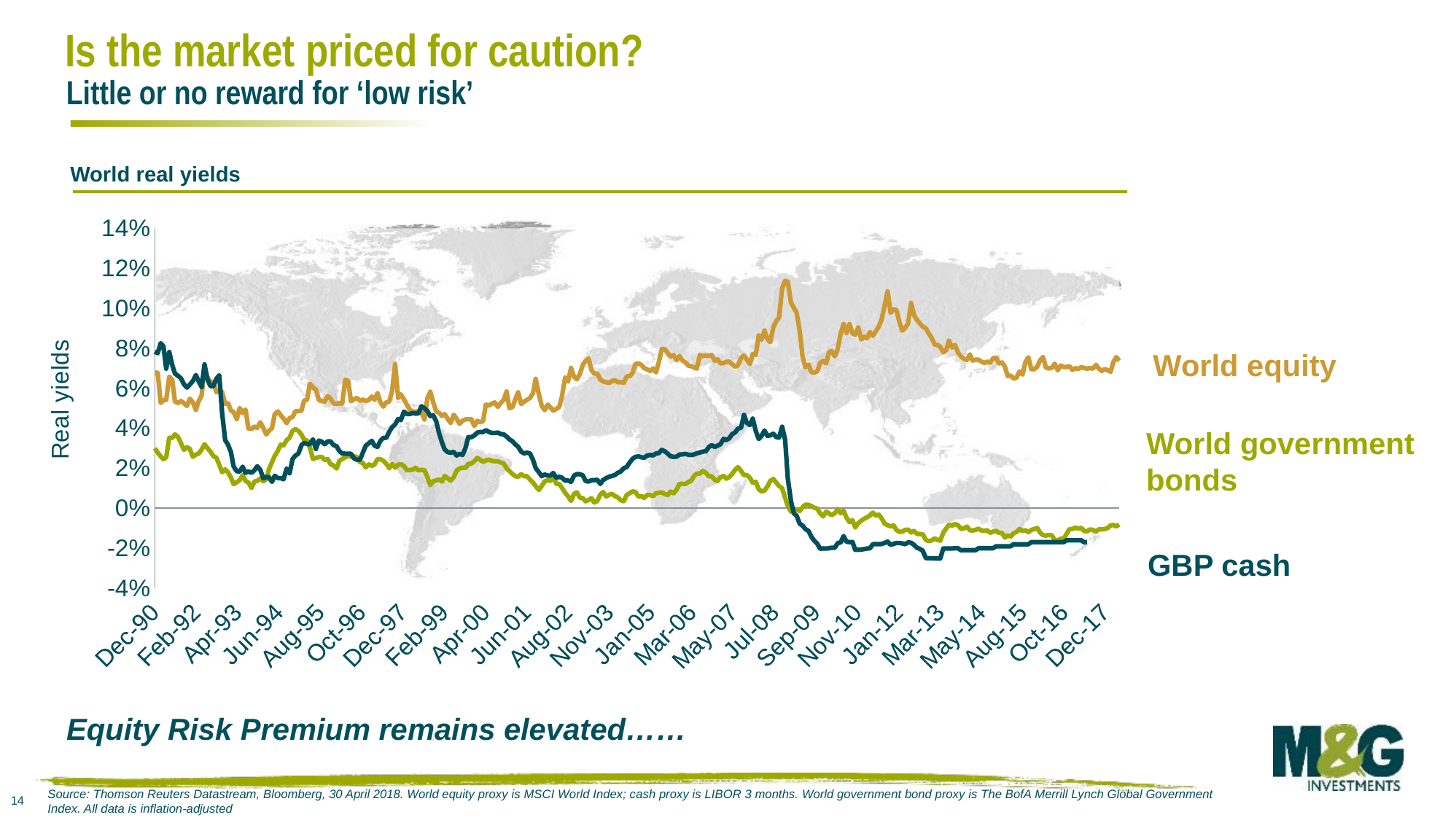
At Dec-90, which is higher: GBP cash or World government bonds? GBP cash Which series has the highest value at Dec-17? World equity How many series are plotted on the chart? 3 Does the GBP cash series rise or fall overall from Dec-90 to Dec-17? fall Is the peak value for World equity around Jul-08 greater or less than 10%? greater What is the title of the chart? World real yields Is the value for World government bonds at Dec-17 greater or less than 0%? less Is the value for World equity at Dec-17 greater or less than 6%? greater What is the label on the vertical axis of the chart? Real yields What kind of chart is shown on the slide? Line chart